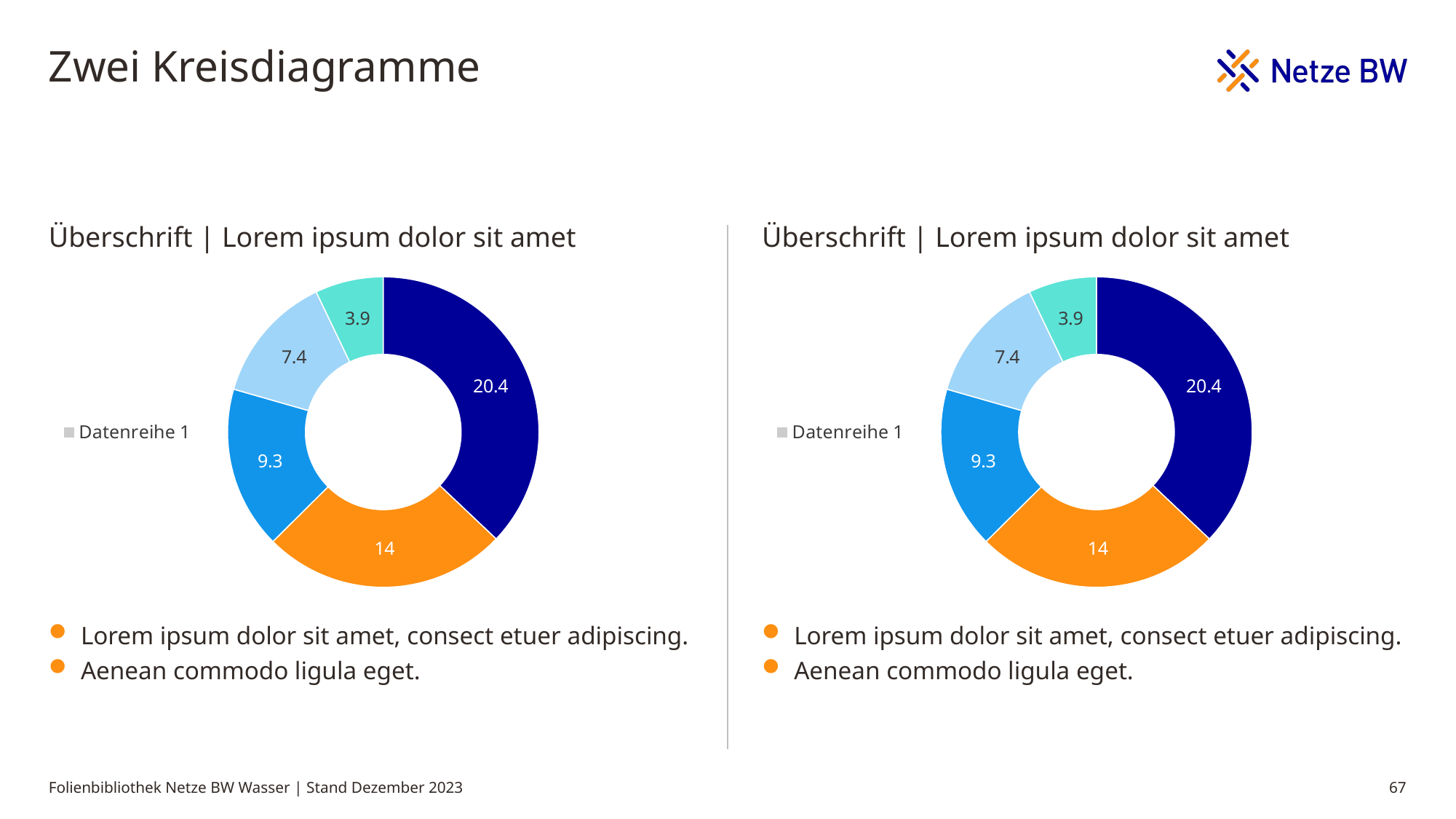
What kind of chart is the left chart on the slide? Doughnut (pie) chart In the right chart, what is the total of all slice values? 55 What is the legend entry shown next to the left chart? Datenreihe 1 In the left chart, what is the smallest slice value? 3.9 In the right chart, what is the largest slice value? 20.4 In the right chart, how many series does the legend list? 1 In the left chart, what is the value of the teal (green) slice? 3.9 In the right chart, what is the difference between the largest slice (20.4) and the orange slice (14)? 6.4 In the right chart, what is the value of the orange slice? 14 In the left chart, which slice is larger: the medium blue slice (9.3) or the light blue slice (7.4)? The medium blue slice (9.3) In the left chart, what is the value of the dark blue slice? 20.4 In the left chart, how many slices does the doughnut have? 5